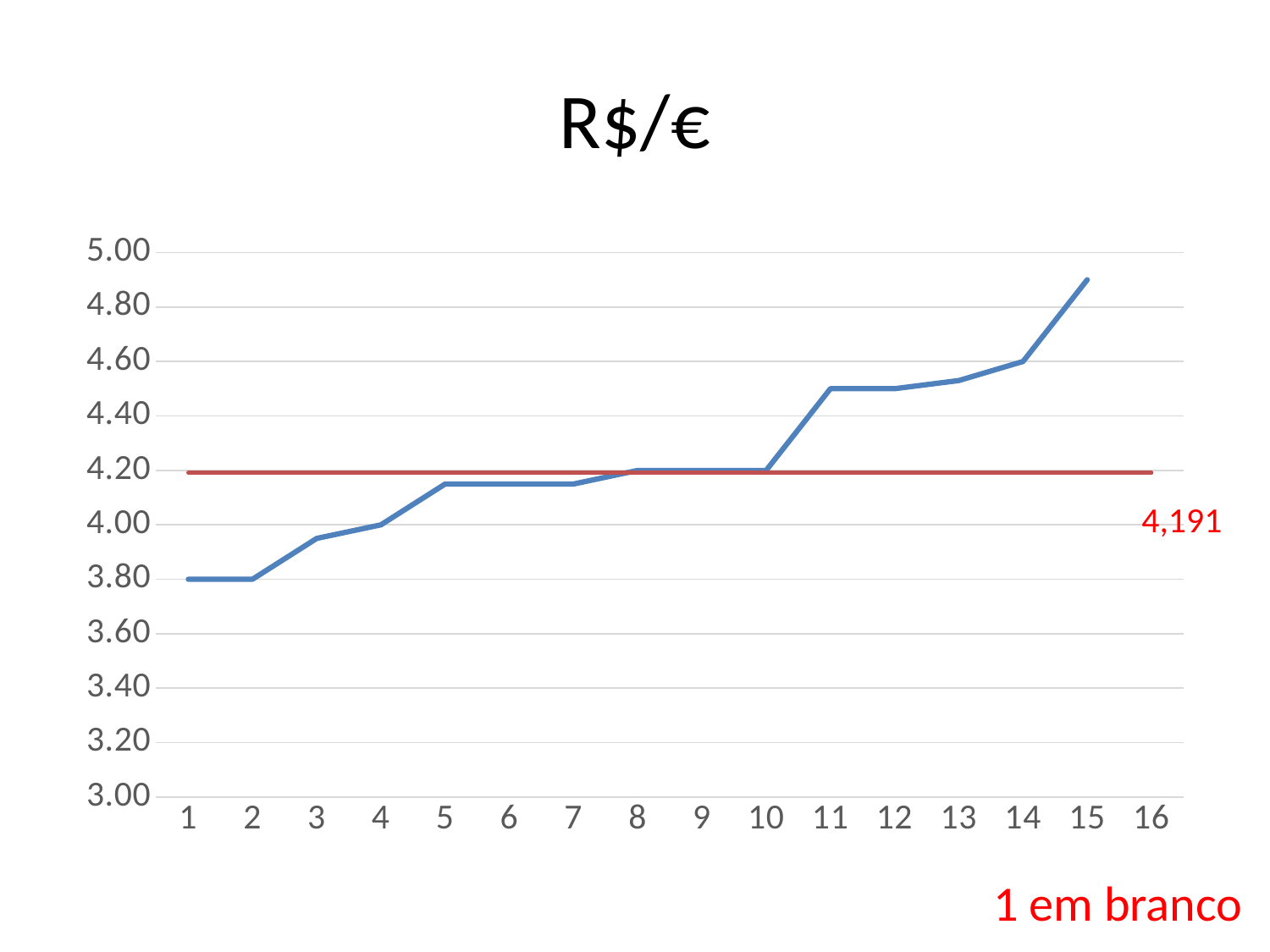
What value is printed next to the red horizontal line? 4,191 Is the value of the blue line at point 3 greater or less than 4.00? less At which x-axis point does the blue line reach its highest value? 15 Which is larger, the blue line's value at point 1 or at point 15? point 15 What is the value of the blue line at point 4? 4.00 What kind of chart is shown on the slide? line chart Is the value of the blue line at point 11 greater or less than 4.40? greater What is the title of the chart? R$/€ What is the value of the blue line at point 1? 3.80 Is the value of the blue line at point 15 greater or less than 4.80? greater Does the blue line generally rise or fall from point 1 to point 15? rise What is the value of the blue line at point 14? 4.60